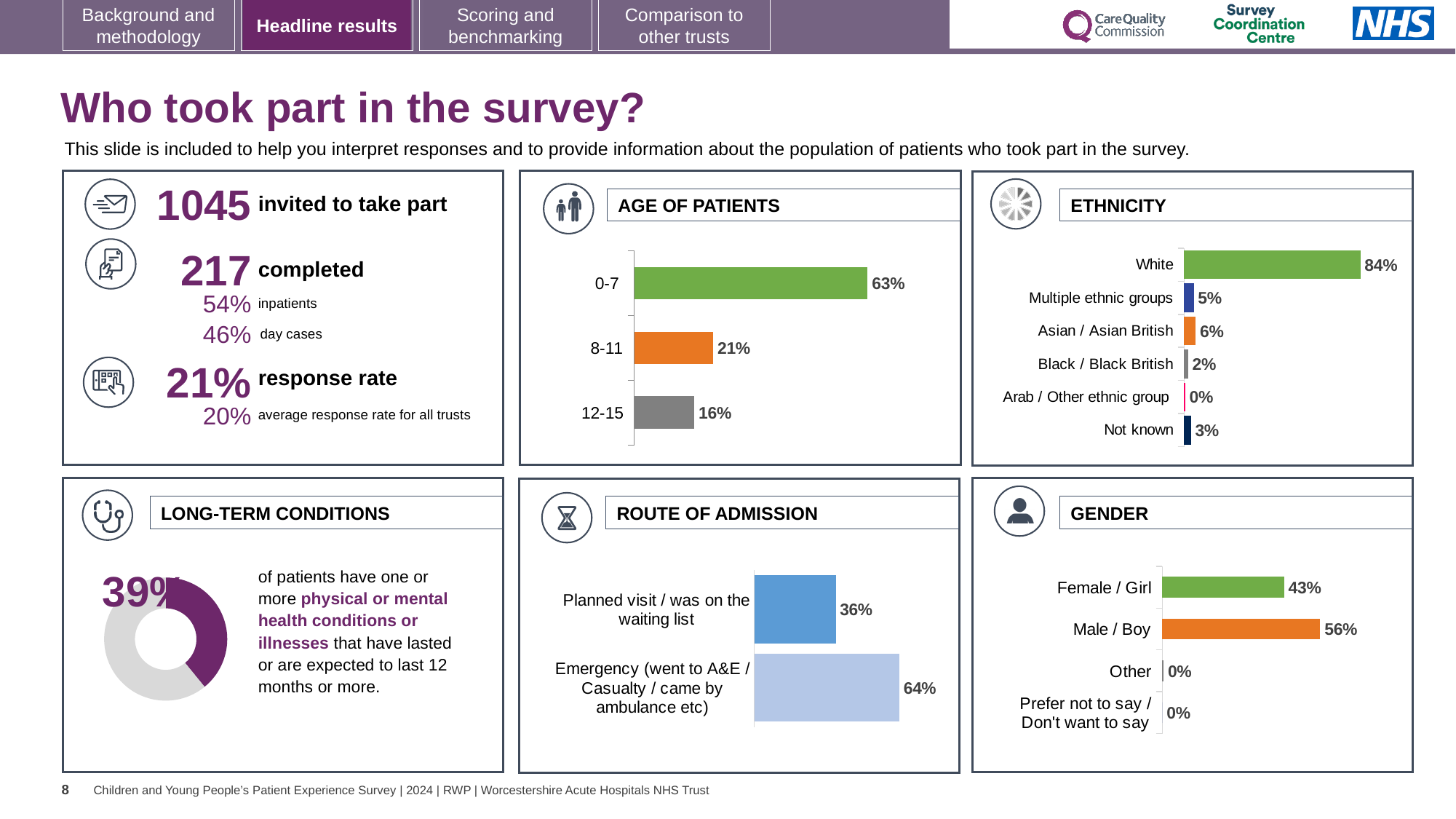
In the GENDER chart, what percentage of patients are Male / Boy? 56% In the ETHNICITY chart, how many ethnicity categories are shown? 6 In the AGE OF PATIENTS chart, what is the difference between the 0-7 and 8-11 percentages? 42% In the AGE OF PATIENTS chart, what percentage of patients are aged 0-7? 63% In the ETHNICITY chart, which is larger: Asian / Asian British or Black / Black British? Asian / Asian British In the ROUTE OF ADMISSION chart, what is the difference between the Emergency and Planned visit percentages? 28% In the ROUTE OF ADMISSION chart, what percentage of patients came via Emergency (went to A&E / Casualty / came by ambulance etc)? 64% In the GENDER chart, which is larger: Female / Girl or Male / Boy? Male / Boy In the ETHNICITY chart, what percentage of patients are White? 84% In the AGE OF PATIENTS chart, which age group has the lowest percentage? 12-15 In the ETHNICITY chart, which category has the highest percentage? White What type of chart is used in the LONG-TERM CONDITIONS panel? Donut chart